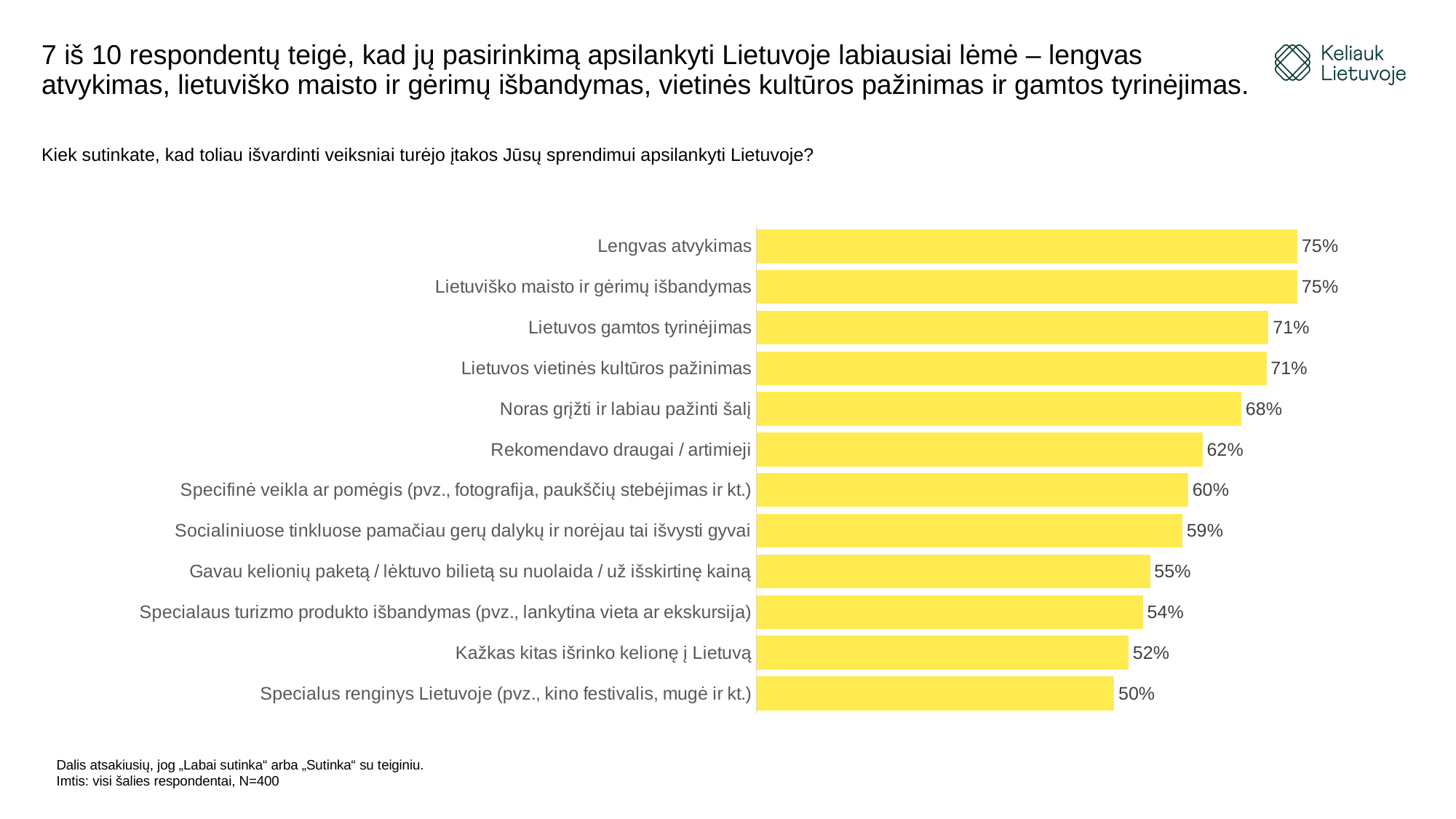
What is the value for "Rekomendavo draugai / artimieji"? 62% What colour are the bars in the chart? Yellow How many categories are shown in the chart? 12 What is the value for "Kažkas kitas išrinko kelionę į Lietuvą"? 52% Which category has the lowest value? Specialus renginys Lietuvoje (pvz., kino festivalis, mugė ir kt.) What is the value for "Gavau kelionių paketą / lėktuvo bilietą su nuolaida / už išskirtinę kainą"? 55% What kind of chart is shown on the slide? Bar chart What is the difference between the values for "Lengvas atvykimas" and "Specialus renginys Lietuvoje (pvz., kino festivalis, mugė ir kt.)"? 25% Which is larger: the value for "Noras grįžti ir labiau pažinti šalį" or the value for "Socialiniuose tinkluose pamačiau gerų dalykų ir norėjau tai išvysti gyvai"? Noras grįžti ir labiau pažinti šalį What is the value for "Lengvas atvykimas"? 75% What is the value for "Noras grįžti ir labiau pažinti šalį"? 68% What is the difference between the values for "Lietuvos gamtos tyrinėjimas" and "Rekomendavo draugai / artimieji"? 9%